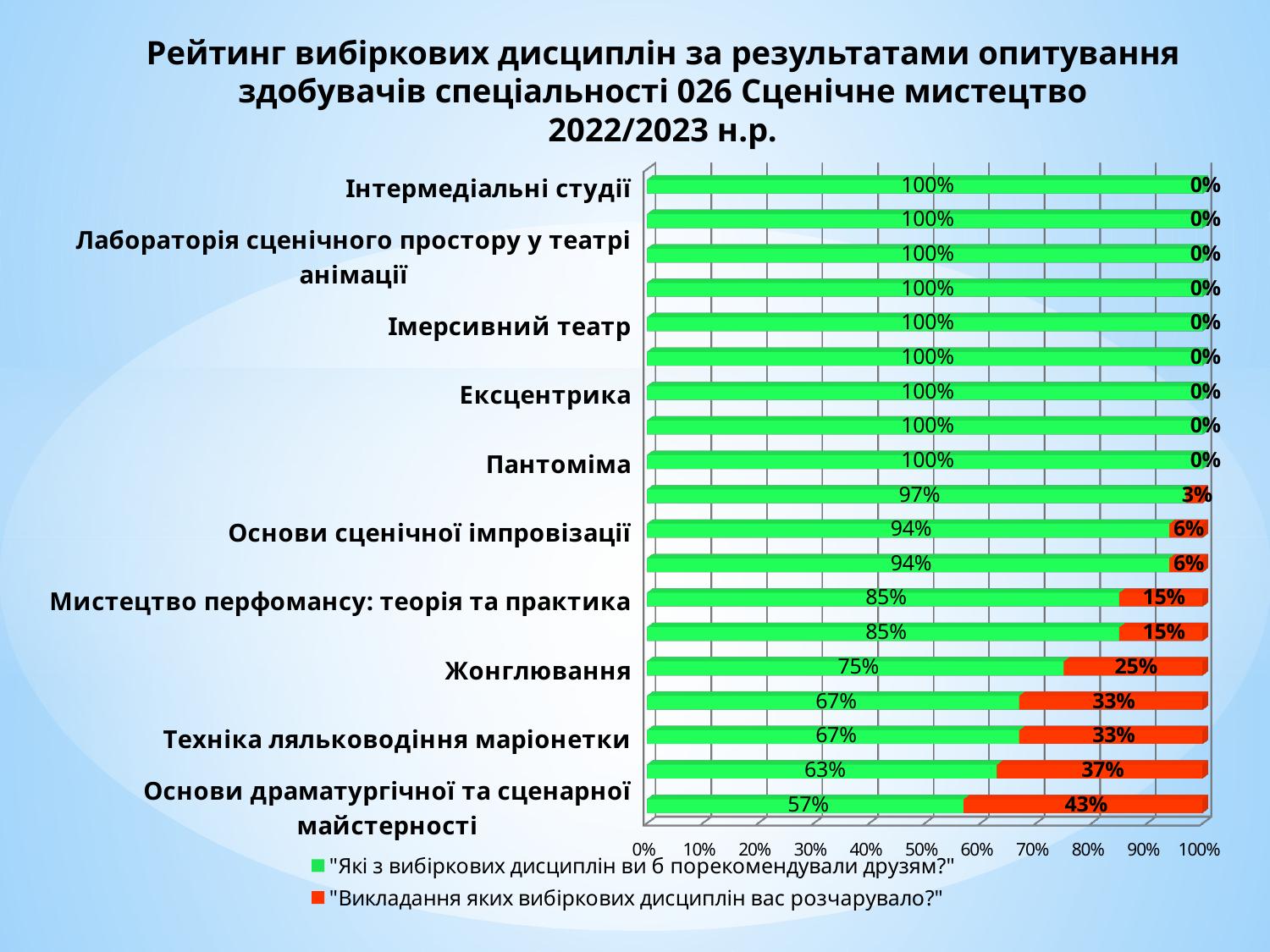
What is the red (disappointed) value for Основи драматургічної та сценарної майстерності? 43% What is the total of the stacked bar for Техніка ляльководіння маріонетки? 100% How many bars are plotted in the chart? 19 What is the red value for Мистецтво перфомансу: теорія та практика? 15% What is the green (recommend to friends) value for Жонглювання? 75% How many series does the legend list? 2 Which has a larger green value, Жонглювання or Техніка ляльководіння маріонетки? Жонглювання Which labelled discipline has the lowest green (recommend) value? Основи драматургічної та сценарної майстерності Which labelled discipline has the highest red (disappointed) value? Основи драматургічної та сценарної майстерності What kind of chart is shown on the slide? bar chart What is the difference between the green and red values for Жонглювання? 50% What is the green value for Основи сценічної імпровізації? 94%